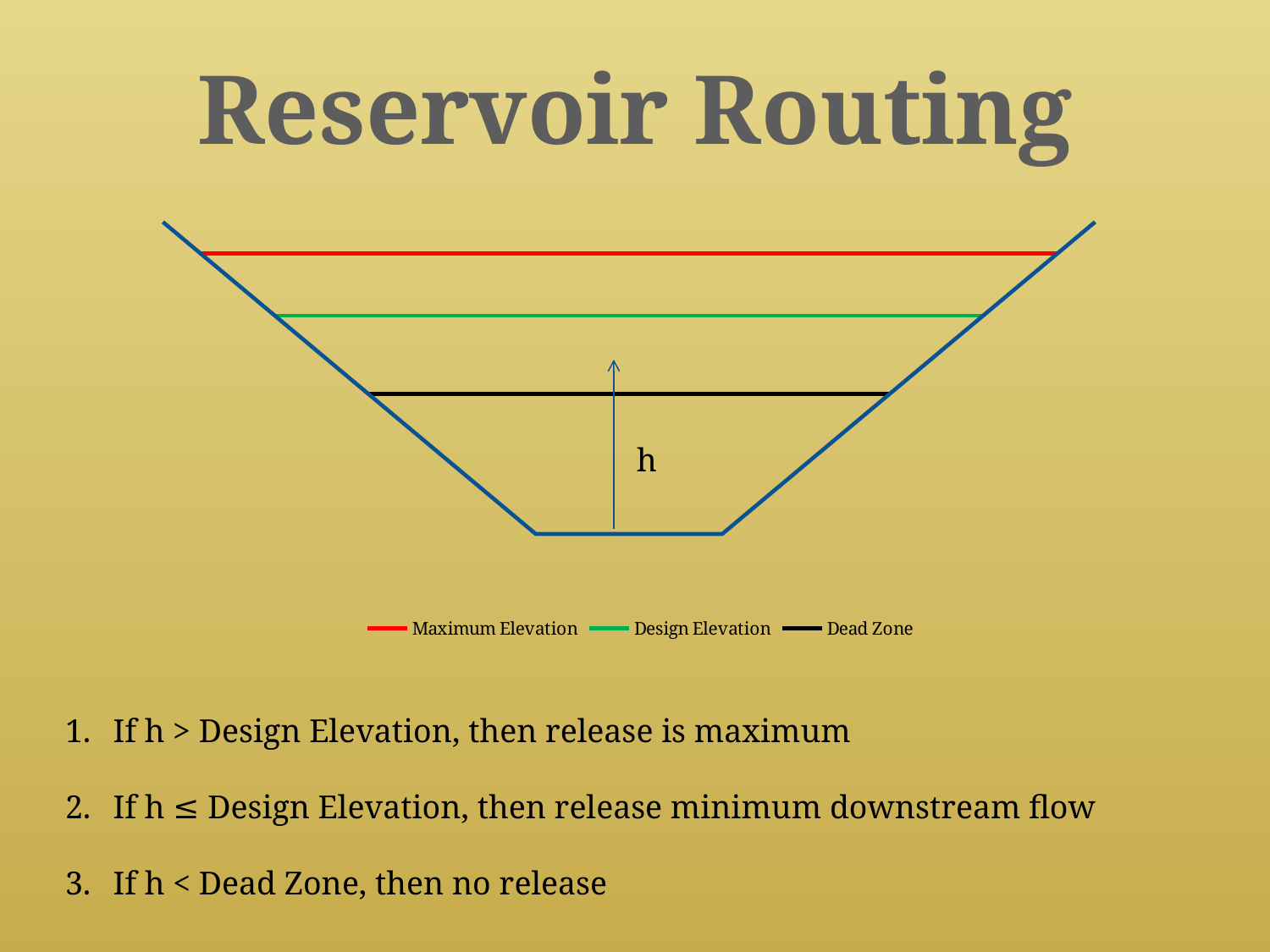
What are the three entries in the legend of the reservoir chart? Maximum Elevation, Design Elevation, Dead Zone Which of the three elevation lines is the widest in the reservoir chart? Maximum Elevation Which of the three elevation lines is the narrowest in the reservoir chart? Dead Zone Which line is higher in the reservoir chart, Maximum Elevation or Design Elevation? Maximum Elevation Which of the three elevation lines is drawn highest in the reservoir chart? Maximum Elevation How many series does the legend of the reservoir chart list? 3 Which of the three elevation lines is drawn lowest in the reservoir chart? Dead Zone How many horizontal elevation lines are drawn inside the reservoir cross-section? 3 What colour is the Maximum Elevation line in the reservoir chart? Red